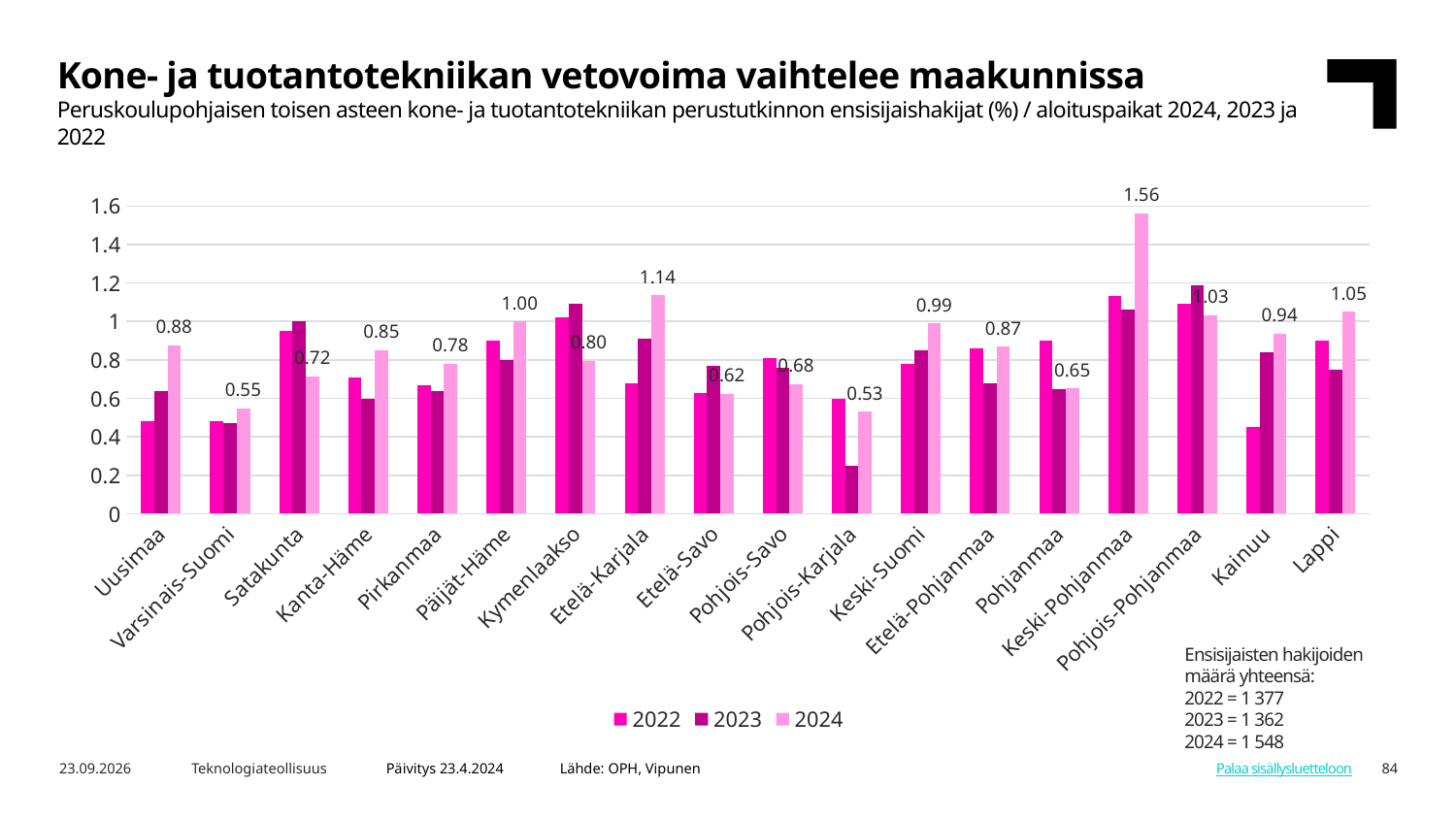
Which region has the lowest 2024 value? Pohjois-Karjala What is the 2024 value for Keski-Pohjanmaa? 1.56 What kind of chart is shown on the slide? Bar chart What is the 2024 value for Varsinais-Suomi? 0.55 Which is larger, the 2024 value for Kainuu or the 2024 value for Pohjanmaa? Kainuu What is the 2024 value for Etelä-Karjala? 1.14 Is the 2022 value for Uusimaa greater or less than 0.6? less How many regions are shown on the x axis? 18 What is the difference between the 2024 values for Keski-Pohjanmaa and Lappi? 0.51 How many series does the legend list? 3 Is the 2023 value for Pohjois-Karjala greater or less than 0.4? less Which region has the highest 2024 value? Keski-Pohjanmaa